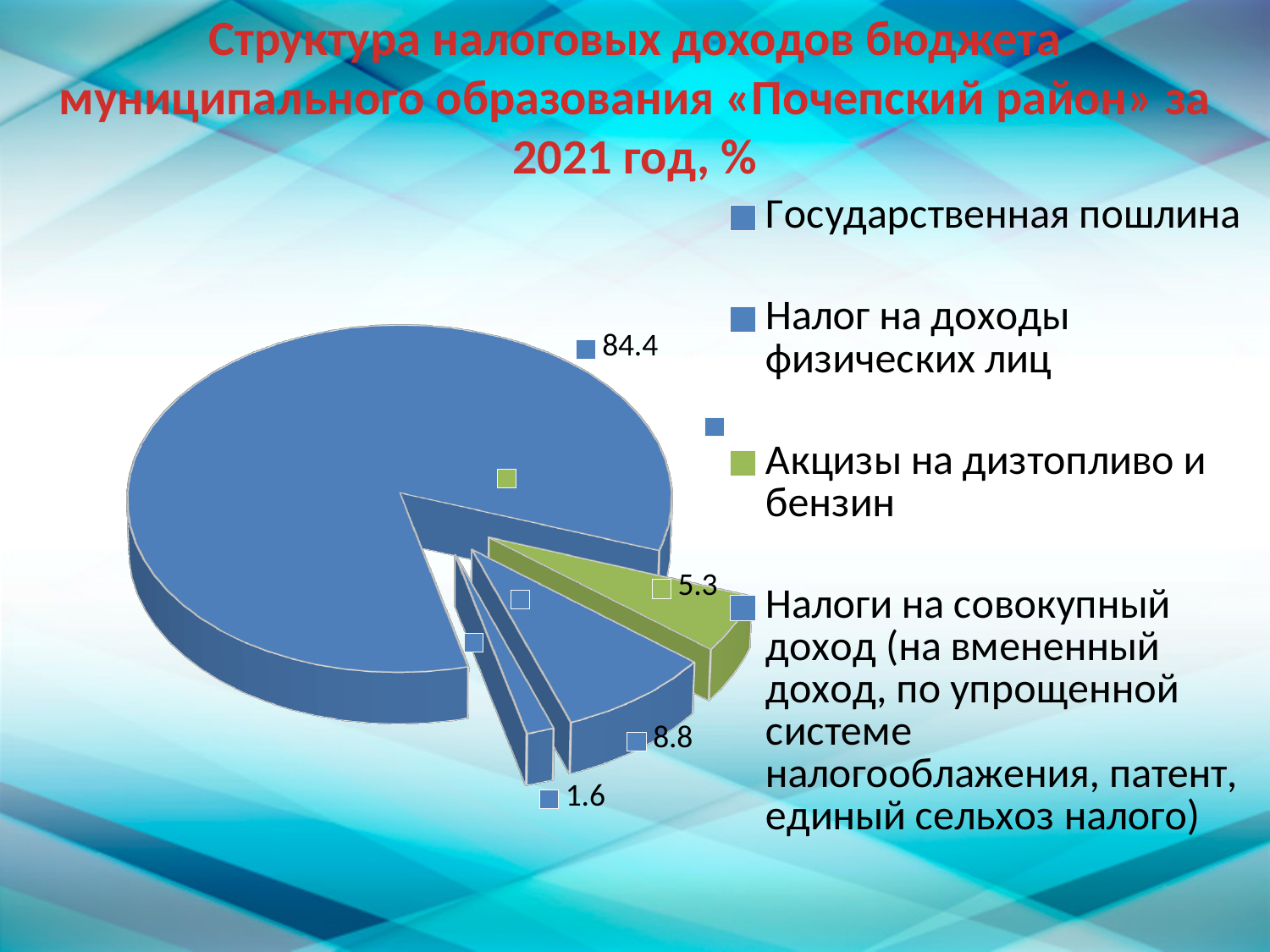
Which is larger: the slice labelled 8.8 or the green slice labelled 5.3? 8.8 How many slices are shown in the pie chart? 4 What is the value of the largest slice of the pie? 84.4 What is the sum of all the data labels shown on the pie chart? 100.1 What value is shown for the green slice (Акцизы на дизтопливо и бензин)? 5.3 What is the difference between the slice labelled 8.8 and the green slice labelled 5.3? 3.5 What kind of chart is shown on the slide? pie chart What is the difference between the largest slice (84.4) and the slice labelled 8.8? 75.6 What colour is the slice for Акцизы на дизтопливо и бензин? green Is the value of the largest slice greater or less than 80? greater What is the title of the chart? Структура налоговых доходов бюджета муниципального образования «Почепский район» за 2021 год, % What is the value of the smallest slice of the pie? 1.6